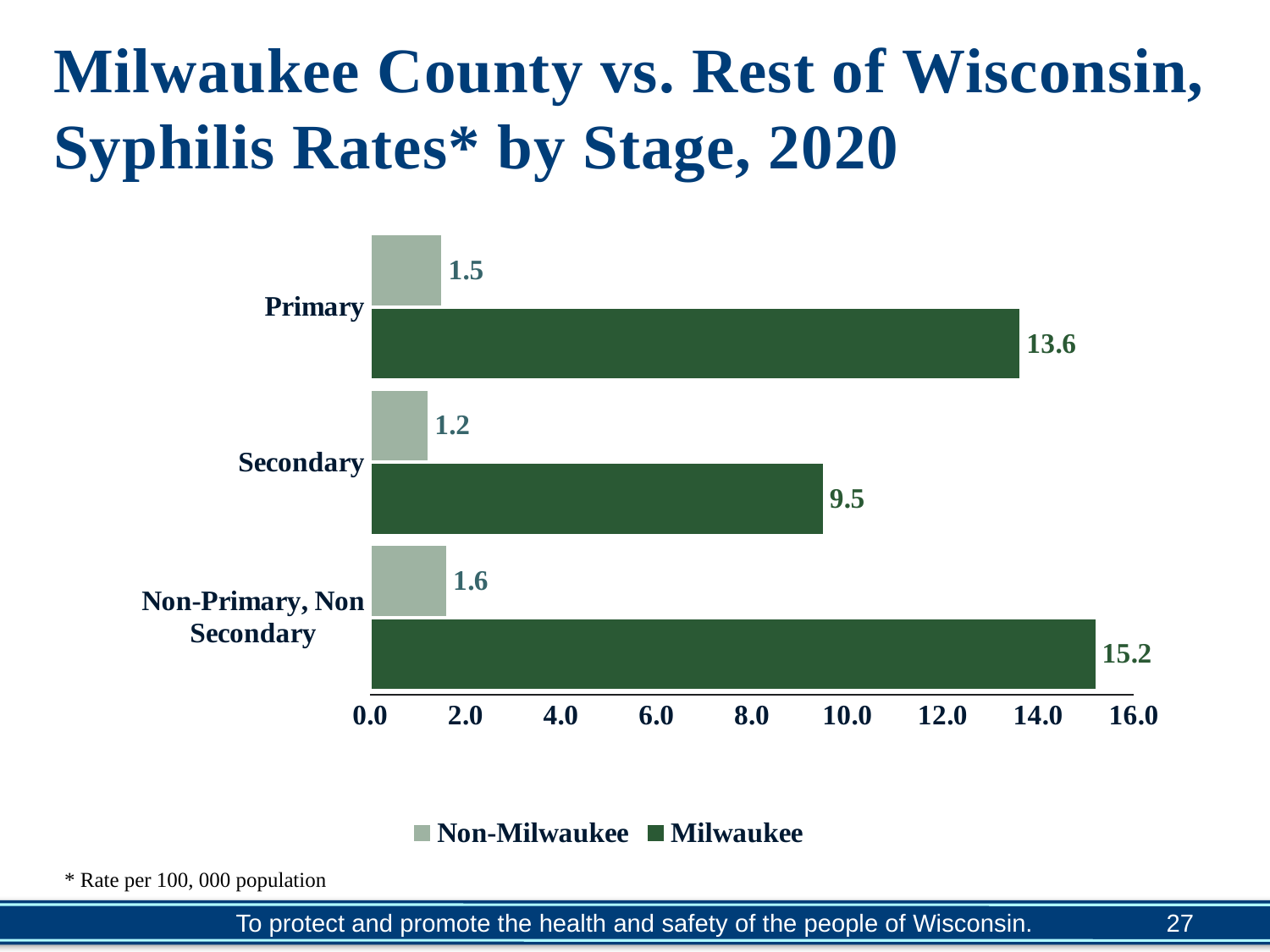
What is the difference between the Milwaukee and Non-Milwaukee rates for the Secondary stage? 8.3 Which stage has the lowest Non-Milwaukee rate? Secondary Is the Milwaukee rate for the Secondary stage greater or less than 10.0? less What are the two series named in the legend? Non-Milwaukee and Milwaukee What is the Non-Milwaukee syphilis rate for the Secondary stage? 1.2 What is the Milwaukee syphilis rate for the Primary stage? 13.6 Which stage has the highest Milwaukee rate? Non-Primary, Non Secondary How many series does the legend list? 2 How many syphilis stages are shown on the chart? 3 What kind of chart is shown on the slide? bar chart What is the Milwaukee rate for the Non-Primary, Non Secondary stage? 15.2 Which is larger, the Milwaukee rate for Primary or the Milwaukee rate for Secondary? Primary